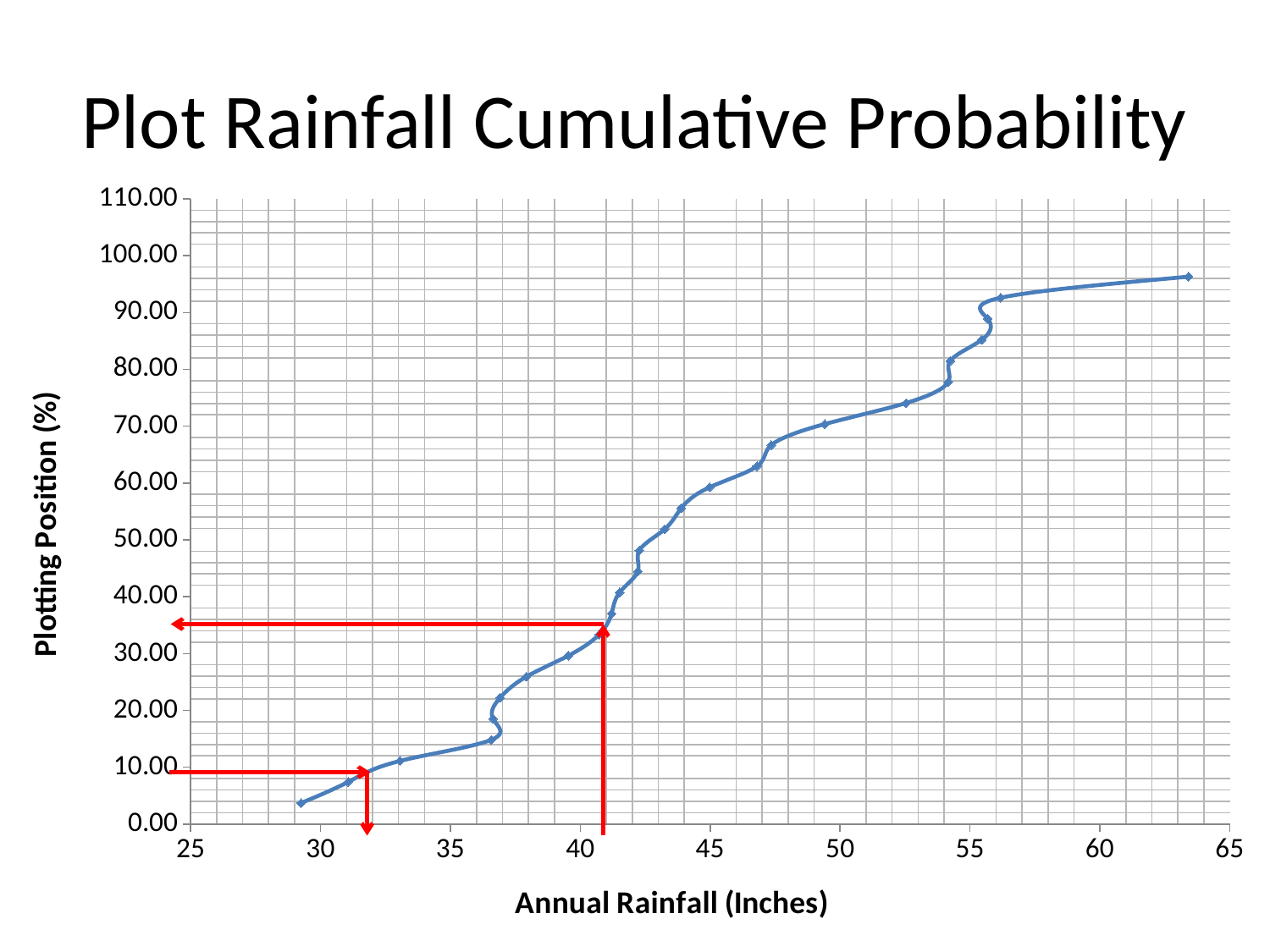
Is the plotting position of the point at about 45 inches of annual rainfall greater or less than 50? greater Is the plotting position of the point at about 56 inches of annual rainfall greater or less than 80? greater What is the highest value shown on the vertical axis? 110.00 What kind of chart is shown on the slide? line chart What is the label of the horizontal axis? Annual Rainfall (Inches) Does the plotting position rise or fall as annual rainfall increases along the x axis? rises What is the title of the chart on the slide? Plot Rainfall Cumulative Probability Is the plotting position of the point at about 49 inches of annual rainfall greater or less than 60? greater Which has the higher plotting position: the point at about 33 inches of rainfall or the point at about 52 inches of rainfall? the point at about 52 inches